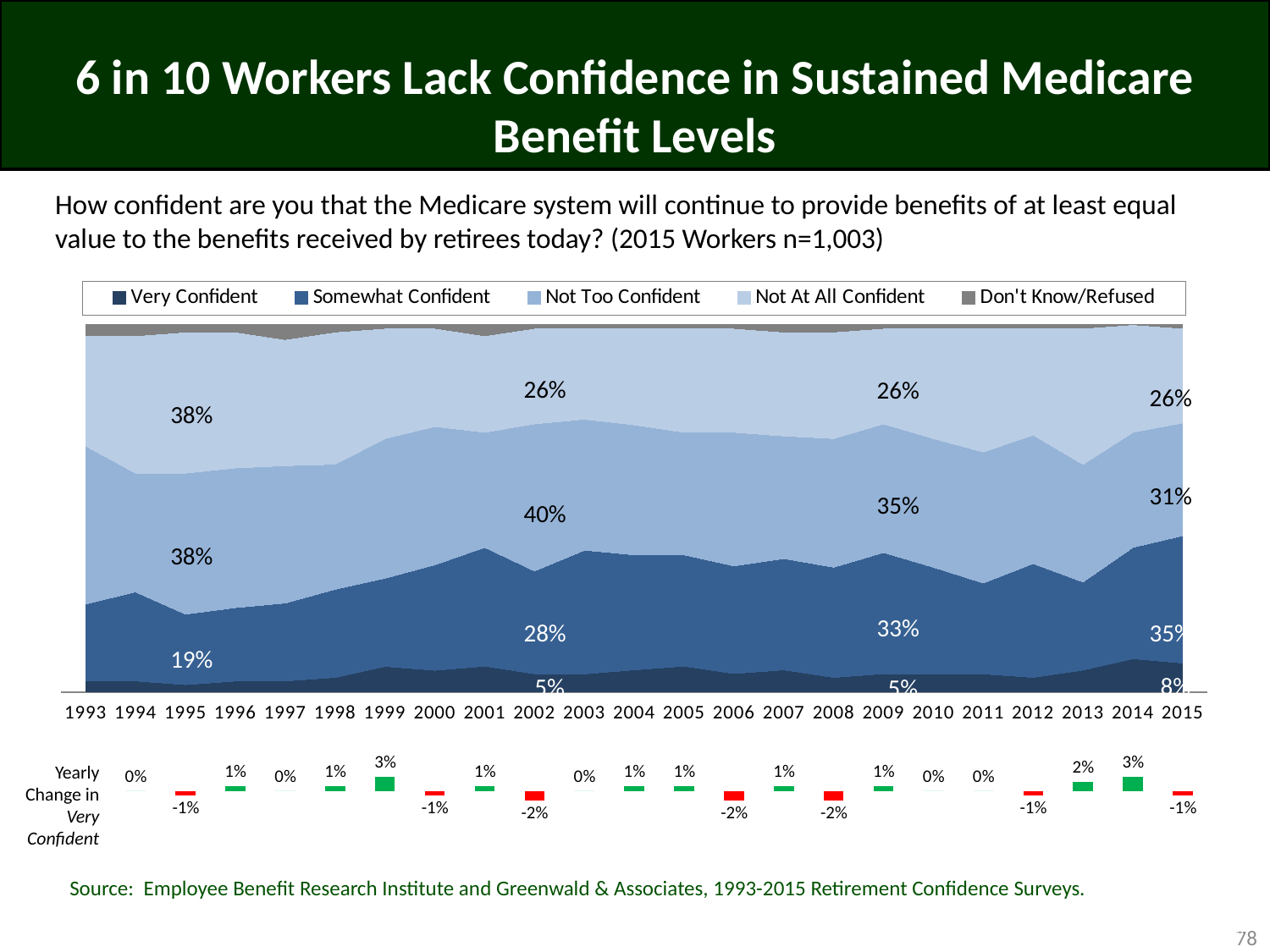
What kind of chart is the main chart on the slide? Stacked area chart In the stacked area chart, what percentage of workers were Somewhat Confident in 2009? 33% In the stacked area chart, did the Not At All Confident share rise or fall from 1995 to 2002? Fall In the stacked area chart, what percentage of workers were Not Too Confident in 2002? 40% In the stacked area chart, was the Not Too Confident share larger in 2009 or in 2015? 2009 In the Yearly Change in Very Confident chart at the bottom, what is the value for 1999? 3% In the Yearly Change in Very Confident chart at the bottom, what is the value for 2008? -2% In the stacked area chart, what percentage of workers were Very Confident in 2015? 8% In the stacked area chart, what percentage of workers were Not At All Confident in 1995? 38% How many series does the legend of the main chart list? 5 In the stacked area chart, by how many percentage points did the Somewhat Confident share change from 2002 to 2015? 7 percentage points How many years are shown along the x axis of the main chart? 23